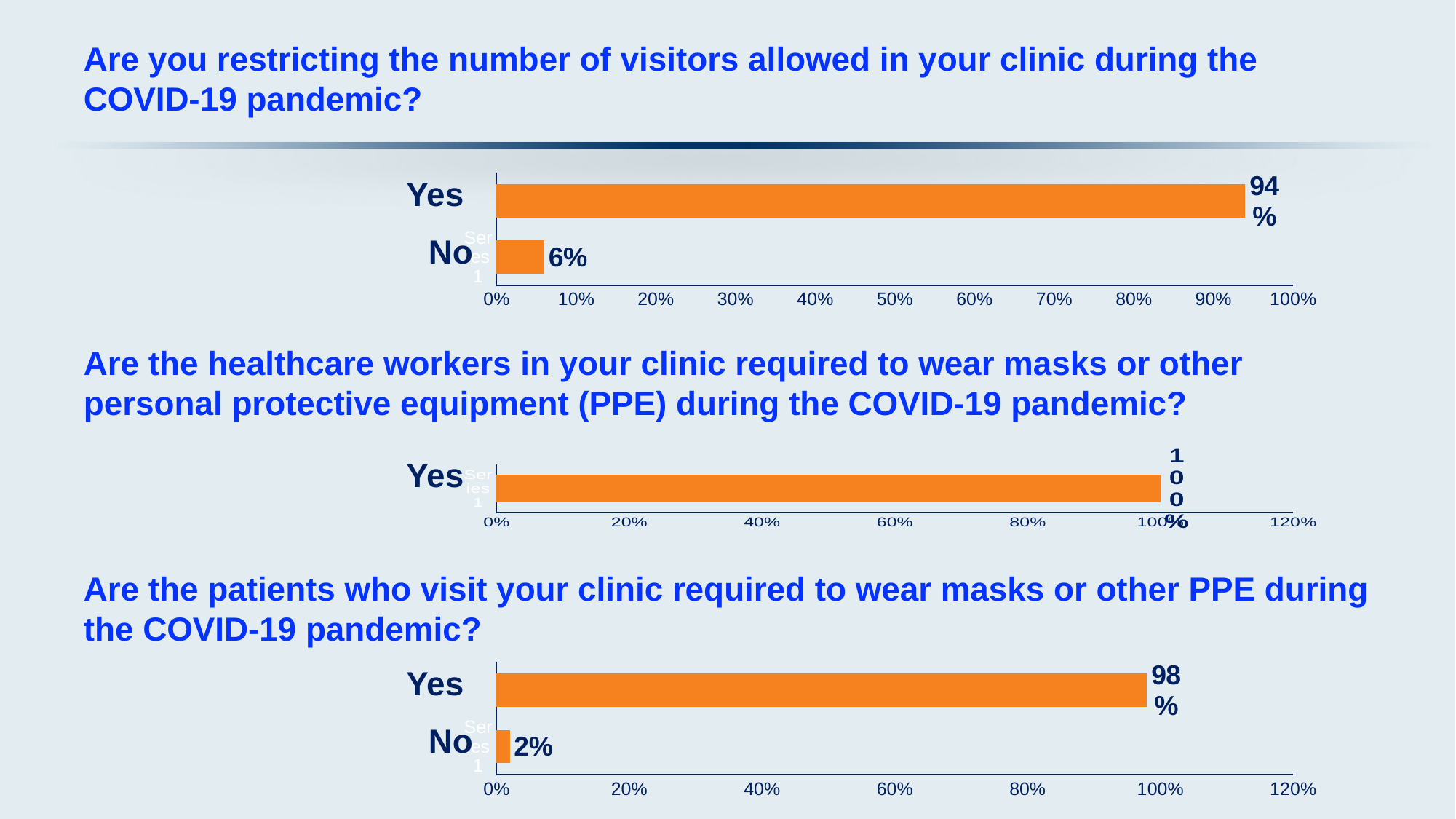
In the bottom chart about patients wearing masks or PPE, what percentage answered Yes? 98% How many response categories are shown in the middle chart about healthcare workers wearing masks or PPE? 1 Is the Yes value in the top chart about restricting the number of visitors greater or less than 90%? greater In the top chart about restricting the number of visitors, which response has the higher percentage? Yes In the bottom chart about patients wearing masks or PPE, what is the difference between the Yes and No percentages? 96% In the top chart about restricting the number of visitors, what is the difference between the Yes and No percentages? 88% In the top chart about restricting the number of visitors, what percentage answered Yes? 94% In the bottom chart about patients wearing masks or PPE, which response has the lowest percentage? No In the top chart about restricting the number of visitors, what percentage answered No? 6% In the bottom chart about patients wearing masks or PPE, what percentage answered No? 2% What type of chart is used in the bottom chart about patients wearing masks or PPE? Bar chart In the middle chart about healthcare workers wearing masks or PPE, what percentage answered Yes? 100%